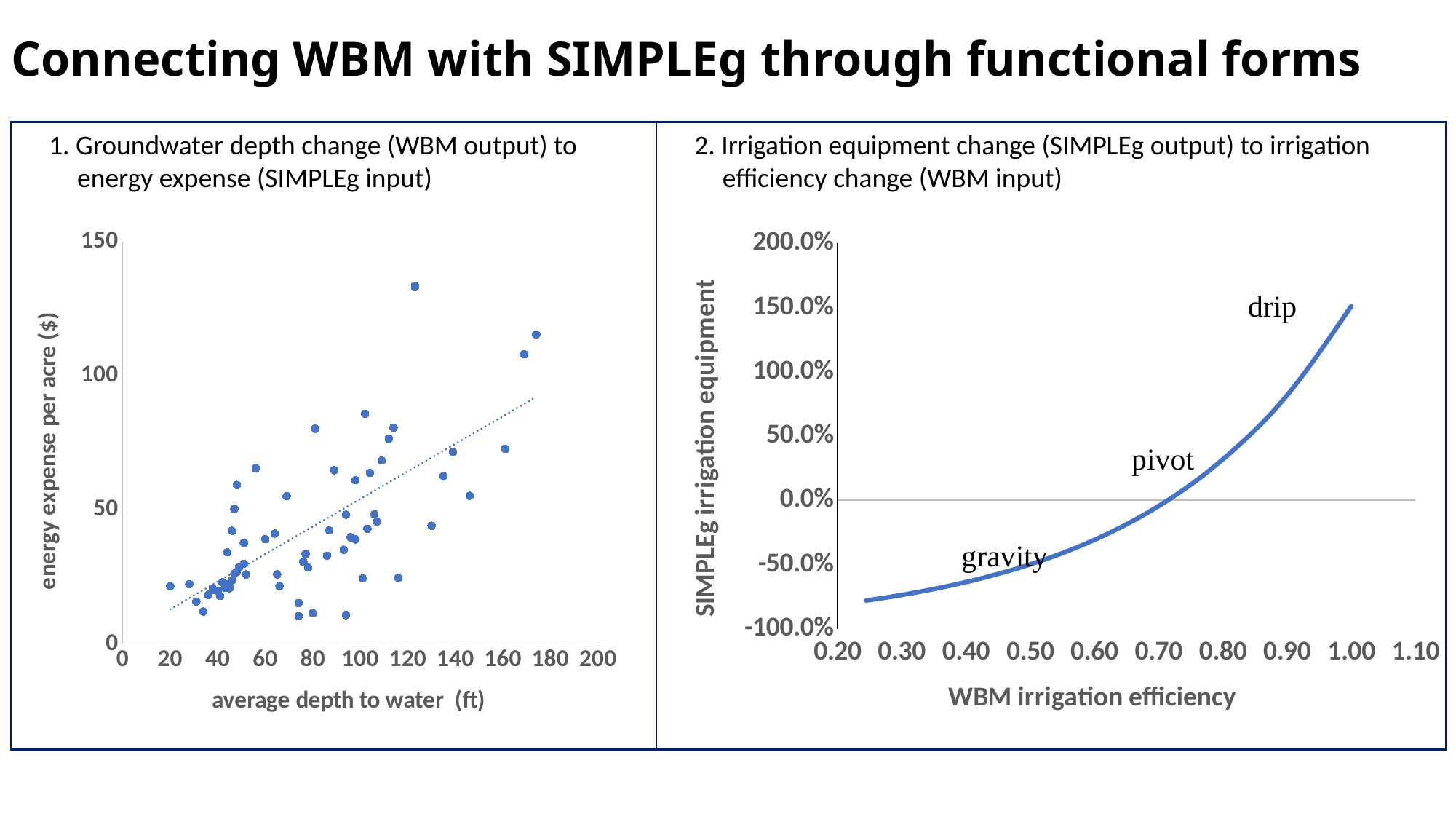
In the right chart, what is the label of the y axis? SIMPLEg irrigation equipment In the left chart, does the dotted trend line rise or fall as average depth to water increases? rises What kind of chart is the left chart, titled "Groundwater depth change (WBM output) to energy expense (SIMPLEg input)"? scatter plot In the right chart, is the value of the curve at a WBM irrigation efficiency of 0.30 greater or less than -50.0%? less In the left chart, what is the label of the x axis? average depth to water (ft) In the right chart, does the curve rise or fall as WBM irrigation efficiency increases? rises What kind of chart is the right chart, titled "Irrigation equipment change (SIMPLEg output) to irrigation efficiency change (WBM input)"? line chart In the right chart, which of the three labelled irrigation types (gravity, pivot, drip) is placed at the lowest point of the curve? gravity In the right chart, is the value of the curve at a WBM irrigation efficiency of 0.90 greater or less than 50.0%? greater In the right chart, is the value of the curve at a WBM irrigation efficiency of 1.00 greater or less than 100.0%? greater In the right chart, which of the three labelled irrigation types (gravity, pivot, drip) is placed at the highest point of the curve? drip